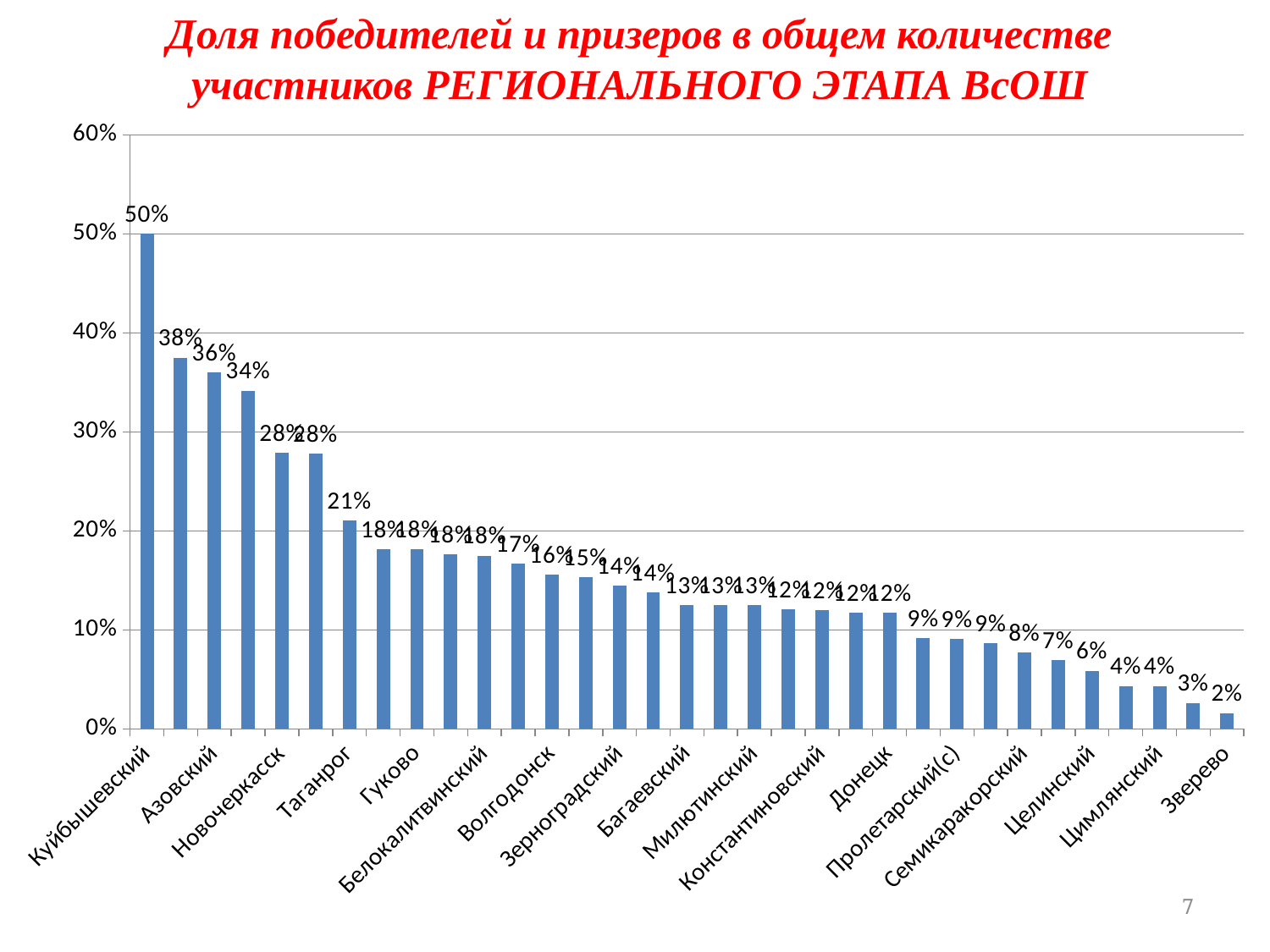
Which is larger, the value for Таганрог or the value for Целинский? Таганрог What is the value for Зверево? 2% What is the value for Куйбышевский? 50% Which category has the highest share of winners and prize-winners? Куйбышевский Is the value for Куйбышевский greater or less than 40%? greater What is the difference between the values for Куйбышевский and Зверево? 48 percentage points Which category has the lowest share of winners and prize-winners? Зверево What is the title of the chart? Доля победителей и призеров в общем количестве участников РЕГИОНАЛЬНОГО ЭТАПА ВсОШ Do the values rise or fall from left to right along the x axis? fall What is the value for Таганрог? 21% What kind of chart is shown on the slide? bar chart What is the value for Азовский? 36%